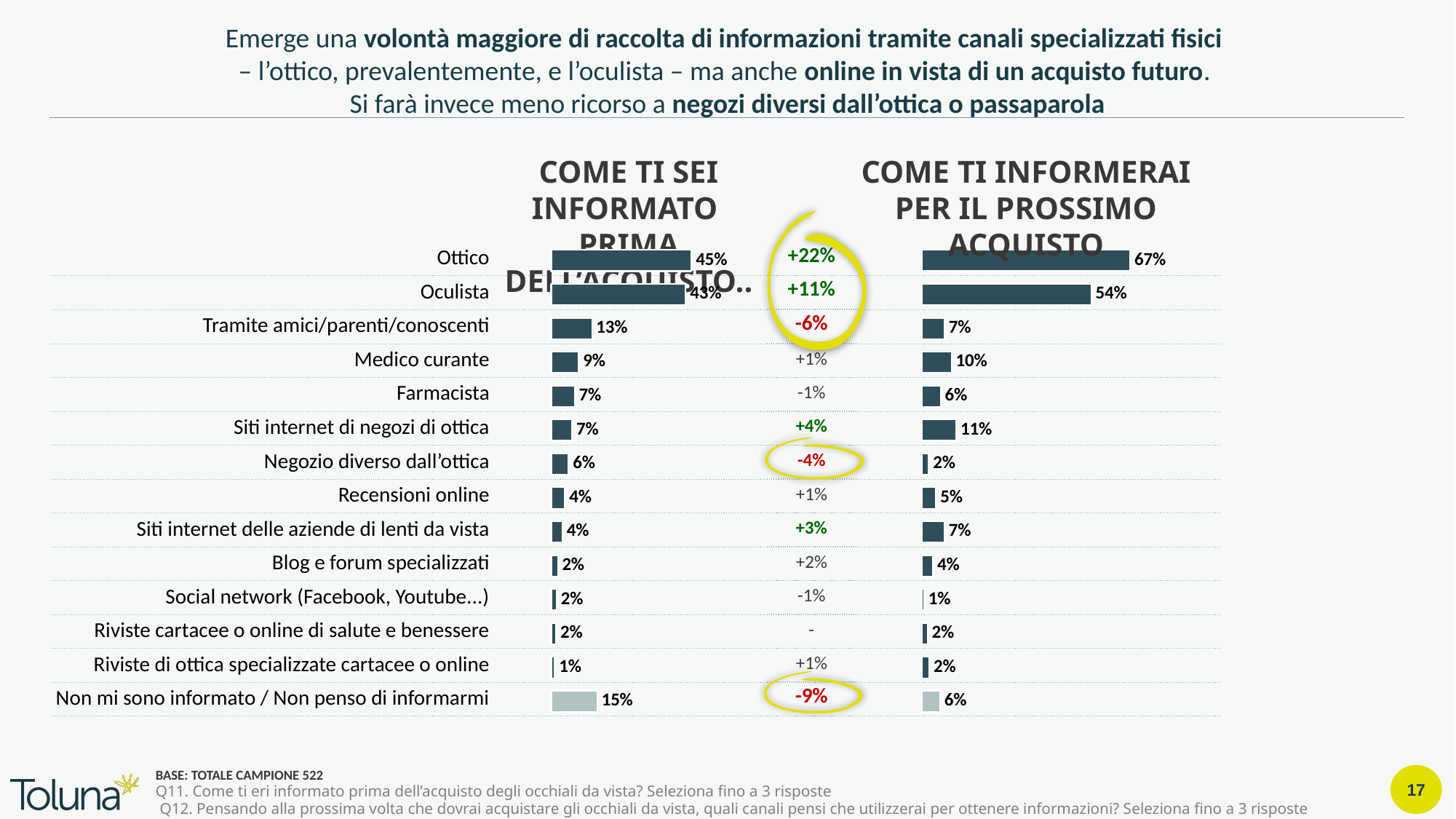
What type of chart is used on this slide? Bar chart In the left chart (COME TI SEI INFORMATO PRIMA DELL'ACQUISTO), which is larger: Tramite amici/parenti/conoscenti or Medico curante? Tramite amici/parenti/conoscenti In the right chart (COME TI INFORMERAI PER IL PROSSIMO ACQUISTO), what is the value for Siti internet di negozi di ottica? 11% In the right chart (COME TI INFORMERAI PER IL PROSSIMO ACQUISTO), which category has the highest value? Ottico In the left chart (COME TI SEI INFORMATO PRIMA DELL'ACQUISTO), what is the value for Non mi sono informato / Non penso di informarmi? 15% What change is printed between the two charts for Negozio diverso dall'ottica? -4% In the left chart (COME TI SEI INFORMATO PRIMA DELL'ACQUISTO), which category has the lowest value? Riviste di ottica specializzate cartacee o online In the left chart (COME TI SEI INFORMATO PRIMA DELL'ACQUISTO), what is the value for Ottico? 45% In the right chart (COME TI INFORMERAI PER IL PROSSIMO ACQUISTO), what is the value for Oculista? 54% How many categories are shown in the right chart (COME TI INFORMERAI PER IL PROSSIMO ACQUISTO)? 14 What is the difference between the Ottico value in the right chart (67%) and in the left chart (45%)? 22% In the right chart (COME TI INFORMERAI PER IL PROSSIMO ACQUISTO), what is the difference between Medico curante and Farmacista? 4%